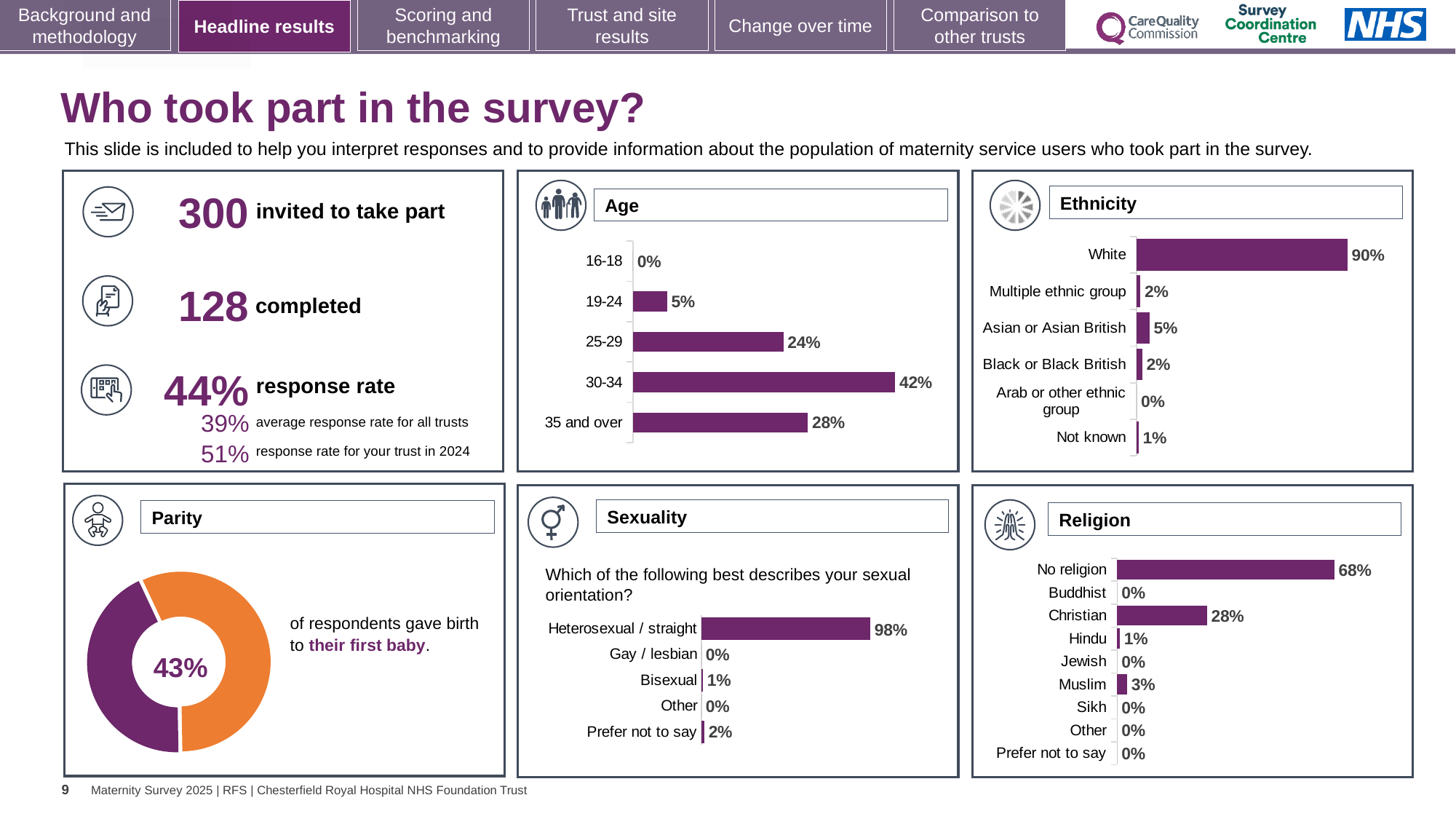
In the Parity chart, what percentage of respondents gave birth to their first baby? 43% In the Sexuality chart, what percentage of respondents answered Prefer not to say? 2% In the Religion chart, what percentage of respondents were Christian? 28% In the Ethnicity chart, what percentage of respondents were White? 90% In the Age chart, what is the difference between the 30-34 and 35 and over percentages? 14% What kind of chart is the Parity chart? Doughnut chart In the Religion chart, which category has the highest percentage? No religion In the Ethnicity chart, how many ethnicity categories are shown? 6 In the Ethnicity chart, which is larger, Asian or Asian British or Black or Black British? Asian or Asian British In the Age chart, what percentage of respondents were aged 30-34? 42% In the Age chart, which age group has the highest percentage? 30-34 In the Sexuality chart, what percentage of respondents answered Heterosexual / straight? 98%